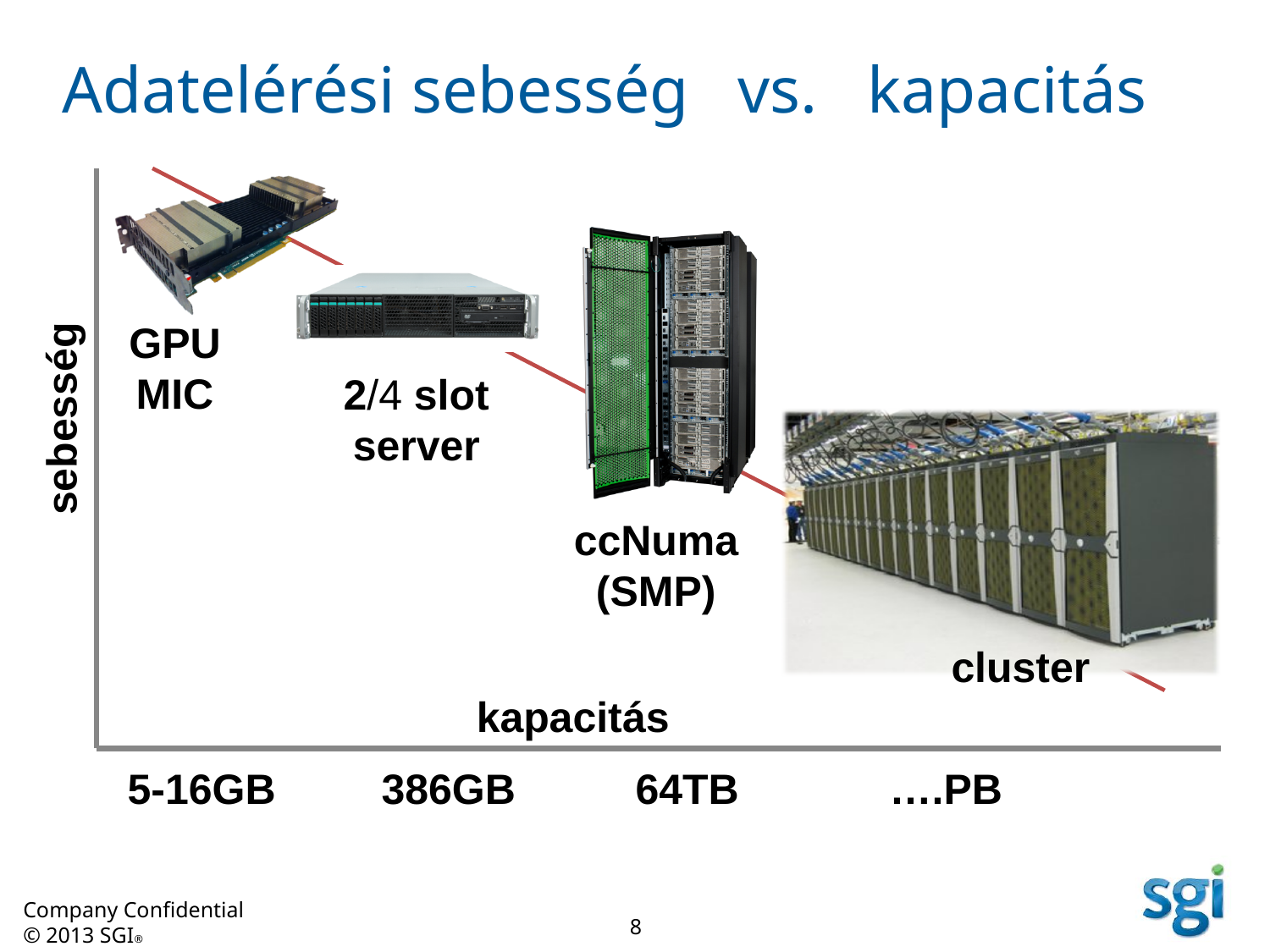
How many system types are placed along the speed-vs-capacity diagram? 4 What capacity is printed under the GPU / MIC position on the horizontal axis? 5-16GB What capacity is printed under the cluster position on the horizontal axis? ….PB What is the label on the horizontal axis of the diagram? kapacitás What is the title of the slide containing the diagram? Adatelérési sebesség vs. kapacitás Which is placed higher on the speed axis, the 2/4 slot server or the ccNuma (SMP) system? 2/4 slot server Does the red line indicating speed rise or fall as capacity increases along the horizontal axis? fall Which system type is placed lowest on the speed (sebesség) axis? cluster What capacity is printed under the ccNuma (SMP) position on the horizontal axis? 64TB Which system type is placed highest on the speed (sebesség) axis? GPU / MIC What capacity is printed under the 2/4 slot server position on the horizontal axis? 386GB What is the label on the vertical axis of the diagram? sebesség